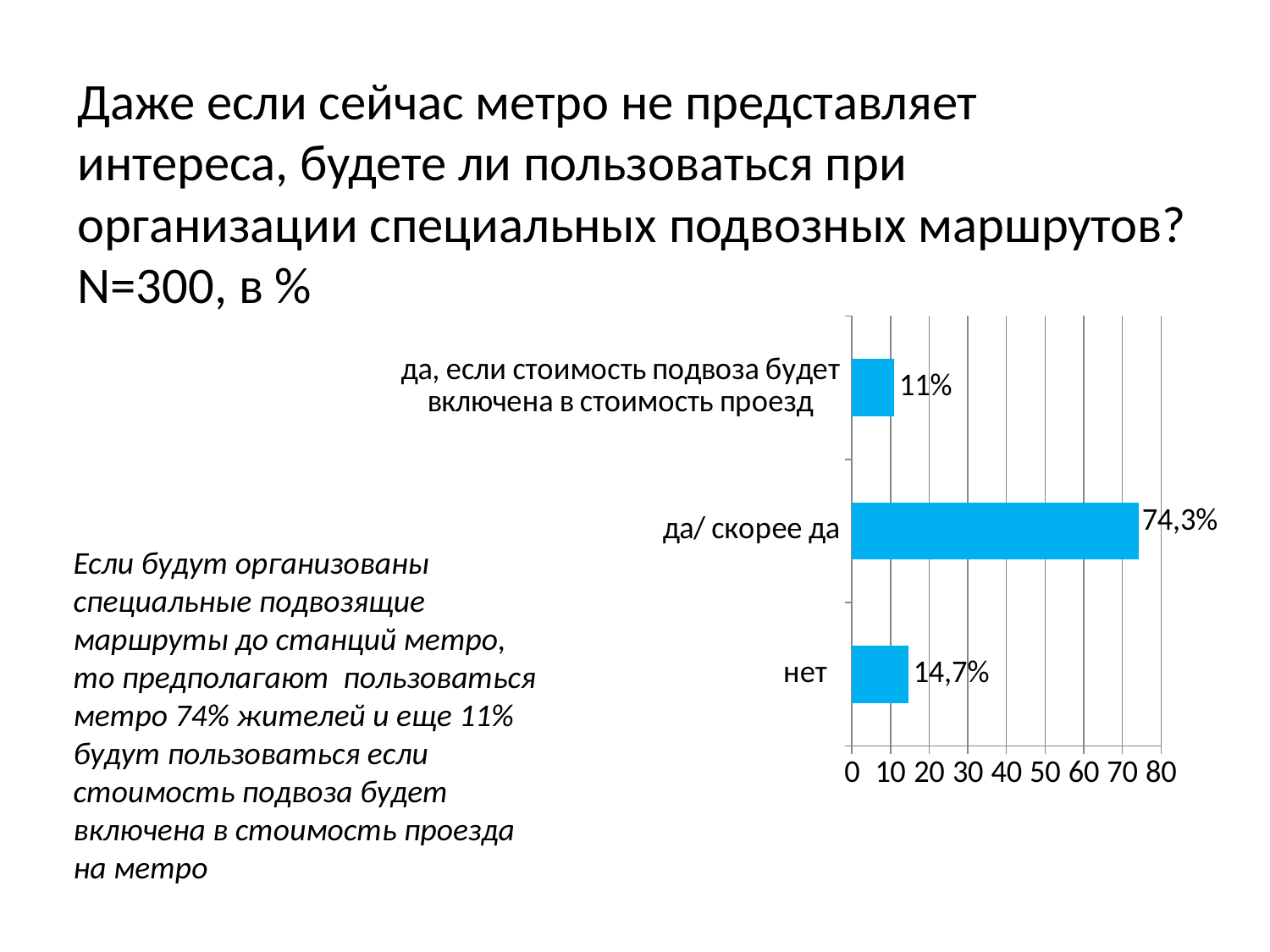
Which category has the lowest value? да, если стоимость подвоза будет включена в стоимость проезд What is the value for "да, если стоимость подвоза будет включена в стоимость проезд"? 11% Which is larger, the value for "нет" or the value for "да, если стоимость подвоза будет включена в стоимость проезд"? нет What is the difference between the values for "да/ скорее да" and "нет"? 59,6% What is the value for "да/ скорее да"? 74,3% Is the value for "да/ скорее да" greater or less than 70? greater How many categories are shown in the chart? 3 What is the value for "нет"? 14,7% What is the difference between the values for "нет" and "да, если стоимость подвоза будет включена в стоимость проезд"? 3,7% What is the maximum value shown on the horizontal axis? 80 What kind of chart is shown on the slide? bar chart Which category has the highest value? да/ скорее да